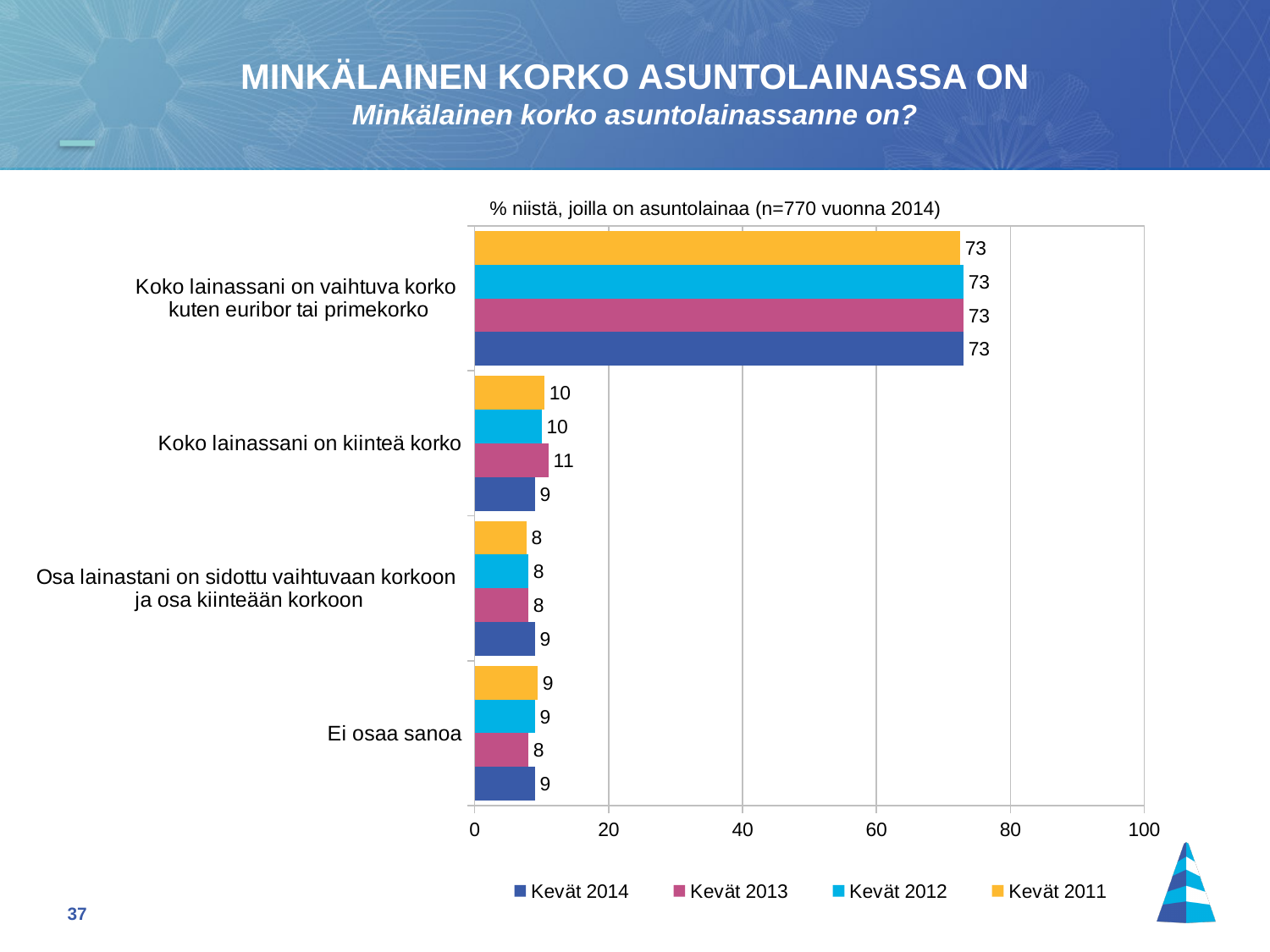
How many categories are shown on the chart? 4 What is the value for "Ei osaa sanoa" in Kevät 2012? 9 What is the difference between the Kevät 2013 value for "Koko lainassani on kiinteä korko" and the Kevät 2014 value for the same category? 2 What kind of chart is shown on the slide? Bar chart Is the Kevät 2011 value for "Koko lainassani on vaihtuva korko kuten euribor tai primekorko" greater or less than 60? greater Which is larger for "Koko lainassani on kiinteä korko": the Kevät 2013 value or the Kevät 2014 value? Kevät 2013 Which category has the highest value in Kevät 2014? Koko lainassani on vaihtuva korko kuten euribor tai primekorko What is the value for "Koko lainassani on vaihtuva korko kuten euribor tai primekorko" in Kevät 2014? 73 What is the sample size stated in the chart subtitle for 2014? n=770 What is the value for "Osa lainastani on sidottu vaihtuvaan korkoon ja osa kiinteään korkoon" in Kevät 2014? 9 What is the value for "Koko lainassani on kiinteä korko" in Kevät 2013? 11 How many series does the legend list? 4